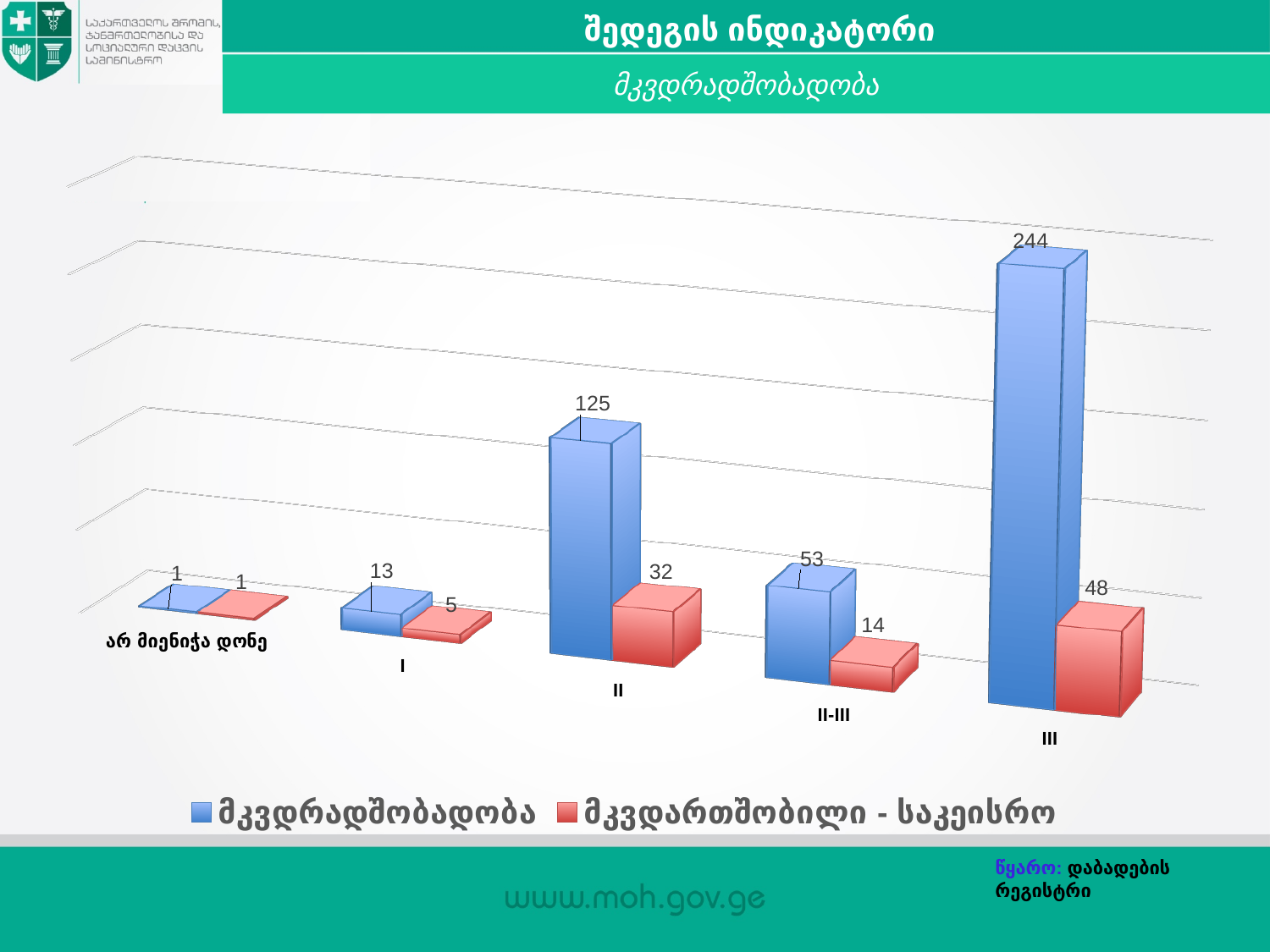
What is the value of მკვდართშობილი - საკეისრო for category II? 32 What is the value of მკვდრადშობადობა for category III? 244 What is the value of მკვდართშობილი - საკეისრო for category I? 5 What colour represents the series მკვდართშობილი - საკეისრო? Red What is the difference between the მკვდრადშობადობა values for III and II? 119 How many series does the legend list? 2 Which is larger: მკვდართშობილი - საკეისრო for III or მკვდრადშობადობა for II-III? მკვდრადშობადობა for II-III What is the value of მკვდრადშობადობა for category II-III? 53 Which category has the highest value for მკვდრადშობადობა? III Which category has the lowest value for მკვდართშობილი - საკეისრო? არ მიენიჭა დონე What kind of chart is shown on the slide? Bar chart How many categories are shown on the x axis? 5